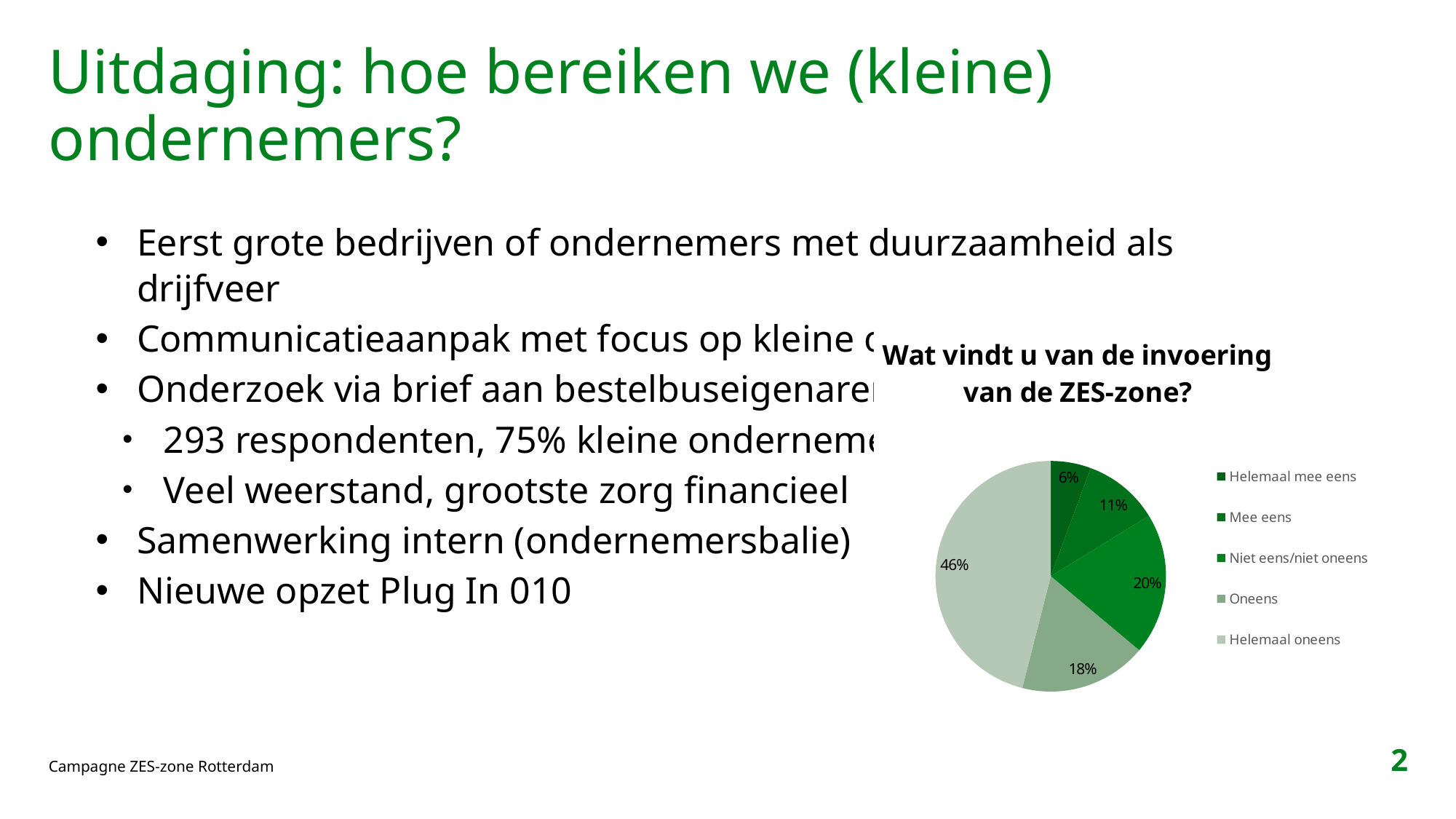
What kind of chart is shown on the slide? pie chart What is the title of the chart? Wat vindt u van de invoering van de ZES-zone? Which answer category has the smallest share of the pie? Helemaal mee eens Which is larger, the share for 'Mee eens' or the share for 'Oneens'? Oneens What percentage of respondents answered 'Oneens'? 18% What percentage of respondents answered 'Helemaal oneens'? 46% What is the difference in percentage points between 'Helemaal oneens' and 'Oneens'? 28 What percentage of respondents answered 'Helemaal mee eens'? 6% What percentage of respondents answered 'Mee eens'? 11% Which answer category has the largest share of the pie? Helemaal oneens What percentage of respondents answered 'Niet eens/niet oneens'? 20% How many slices does the pie chart have? 5